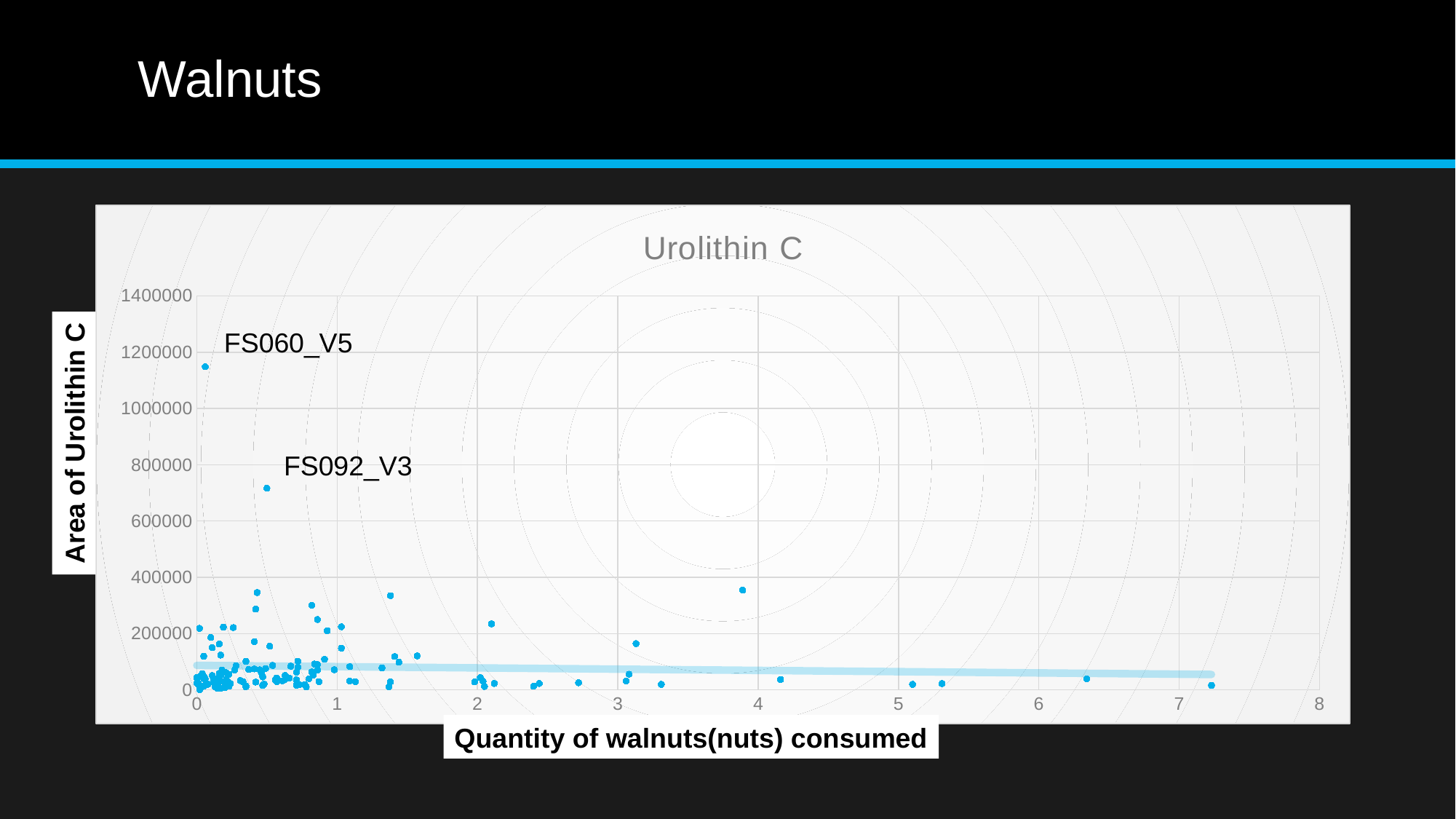
What kind of chart is shown on the slide? scatter plot Which has the higher Area of Urolithin C, FS060_V5 or FS092_V3? FS060_V5 Is the value for FS092_V3 greater or less than 600000? greater What is the label of the x axis of the chart? Quantity of walnuts(nuts) consumed Does the trend line rise or fall as the quantity of walnuts consumed increases? fall Is the value for FS092_V3 greater or less than 800000? less Is the value for FS060_V5 greater or less than 1000000? greater How many data points on the chart are labelled with a sample name? 2 Which labelled point has the highest Area of Urolithin C? FS060_V5 What is the title of the chart? Urolithin C